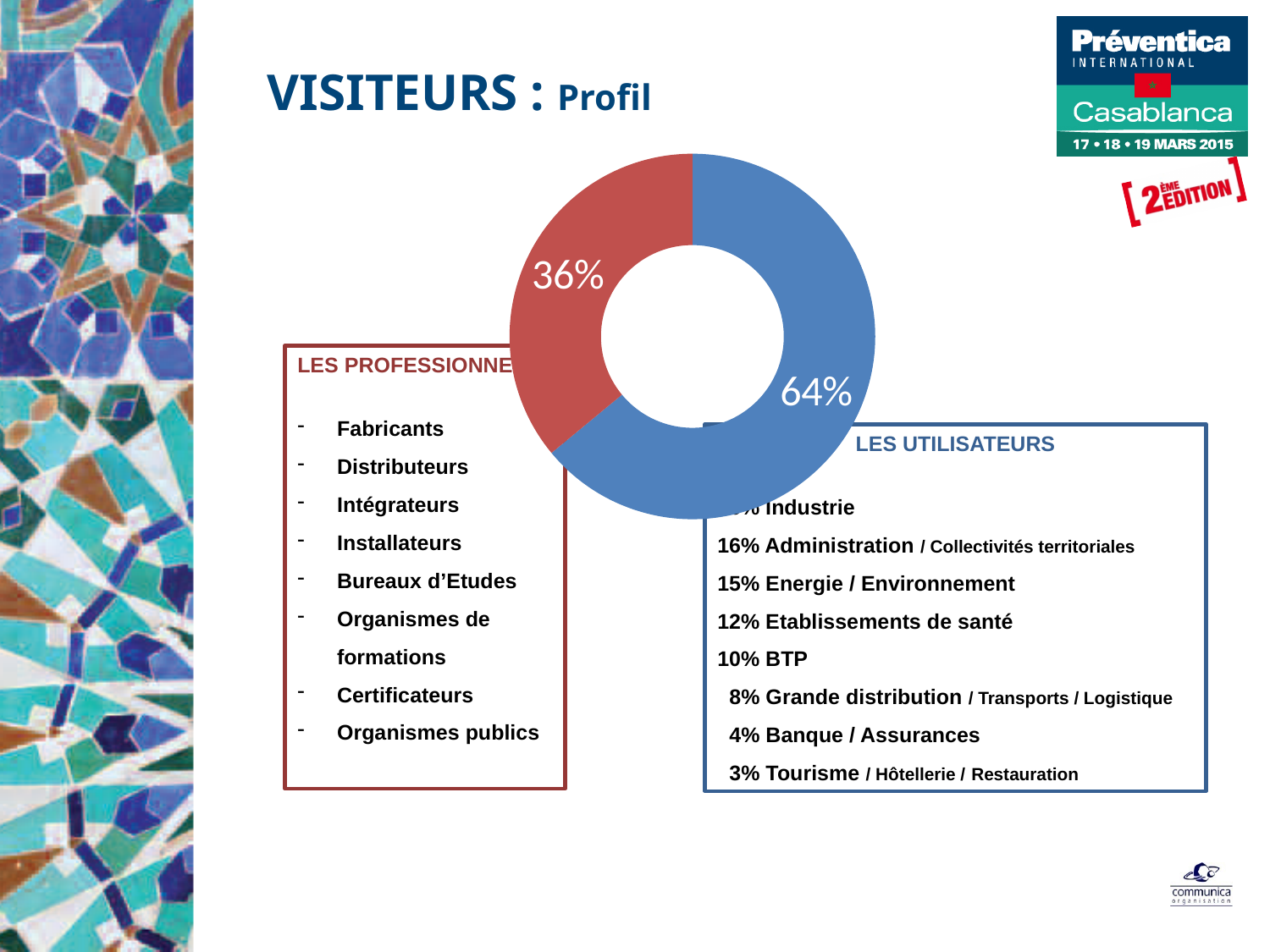
Which is larger, the red slice or the blue slice of the pie chart? the blue slice What is the difference in percentage points between the two slices of the pie chart? 28 percentage points What share of the pie chart corresponds to Les Professionnels (the red box)? 36% What share of the pie chart corresponds to Les Utilisateurs (the blue box)? 64% Is the blue slice of the pie chart greater or less than 50%? greater How many slices does the pie chart have? 2 What percentage is shown on the blue slice of the pie chart? 64% What colour is the 36% slice of the pie chart? red Which slice of the pie chart is the smallest? the red slice (36%) Which slice of the pie chart is the largest? the blue slice (64%) What kind of chart is shown on the slide? pie chart (donut) What percentage is shown on the red slice of the pie chart? 36%